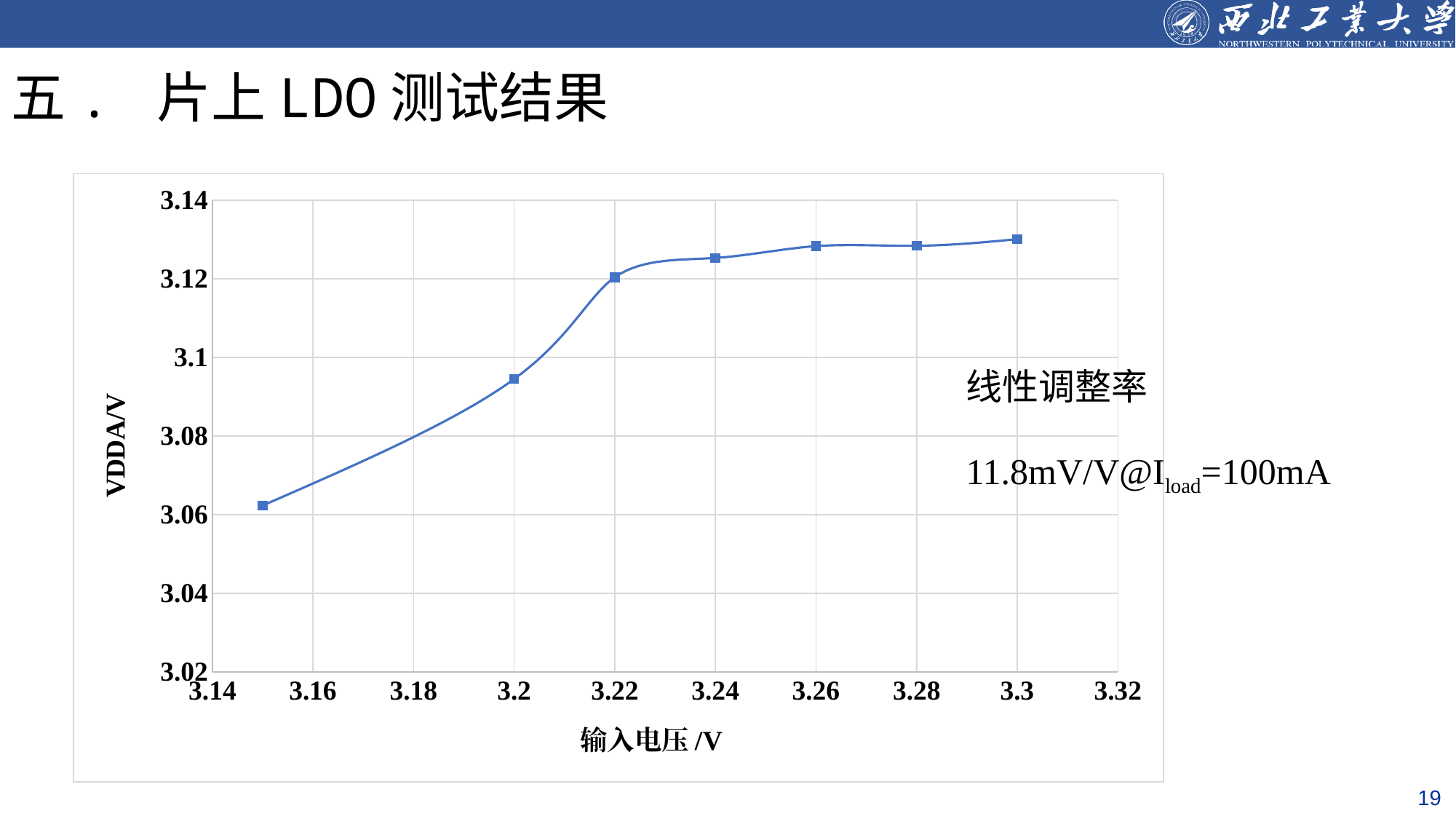
Is the VDDA value at an input voltage of 3.24 greater or less than 3.12? greater Does VDDA rise or fall as the input voltage increases along the x axis? rise Is the VDDA value at an input voltage of 3.3 greater or less than 3.12? greater Which has the larger VDDA value: input voltage 3.15 or input voltage 3.2? 3.2 At which input voltage is VDDA lowest? 3.15 How many data points are plotted on the line? 7 At which input voltage is VDDA highest? 3.3 What line regulation value is stated next to the chart? 11.8mV/V@Iload=100mA Is the VDDA value at an input voltage of 3.15 greater or less than 3.08? less What kind of chart is shown on the slide? line chart What is the label of the y axis? VDDA/V